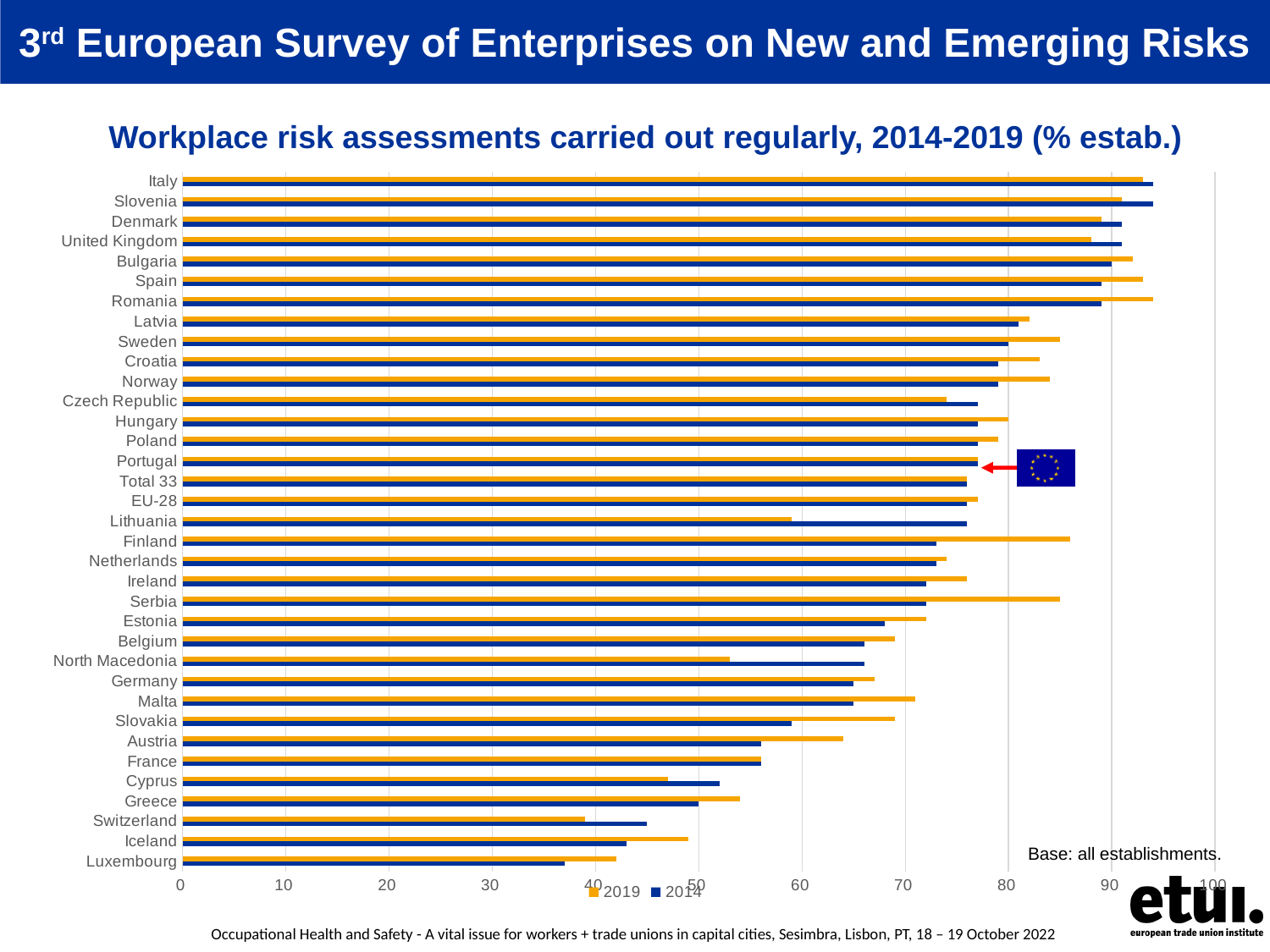
For Lithuania, which is larger: the 2014 value or the 2019 value? 2014 Which country has the lowest 2014 value? Luxembourg Is the 2014 value for Italy greater or less than 90? greater How many countries or groups are listed on the vertical axis of the chart? 35 Is the 2014 value for Luxembourg greater or less than 40? less Is the 2019 value for Cyprus greater or less than 50? less What is the title of the chart? Workplace risk assessments carried out regularly, 2014-2019 (% estab.) Which series is shown in orange in the chart? 2019 How many series does the legend list? 2 What kind of chart is shown on the slide? Bar chart For Serbia, which is larger: the 2014 value or the 2019 value? 2019